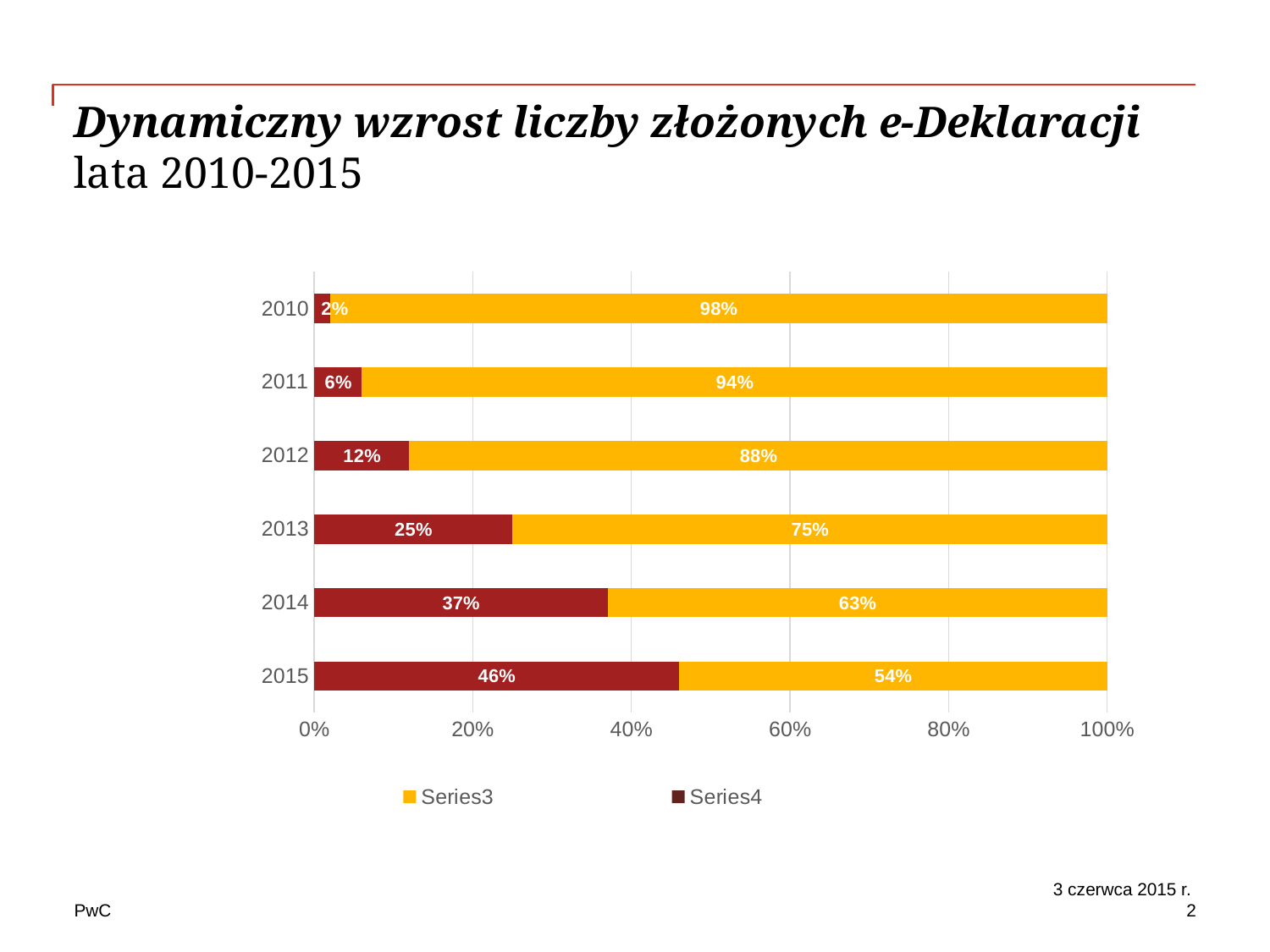
Does the Series4 value rise or fall from 2010 to 2015? Rise What is the total of the stacked bar for 2014? 100% What is the value of Series3 for 2012? 88% Which year has the lowest value for Series3? 2015 Which is larger: the Series3 value for 2013 or the Series3 value for 2014? 2013 How many series does the legend list? 2 Which year has the highest value for Series4? 2015 What kind of chart is shown on the slide? Stacked bar chart How many years are shown on the chart? 6 What is the difference between the Series4 values for 2014 and 2013? 12% What is the value of Series4 for 2015? 46% What is the value of Series4 for 2010? 2%